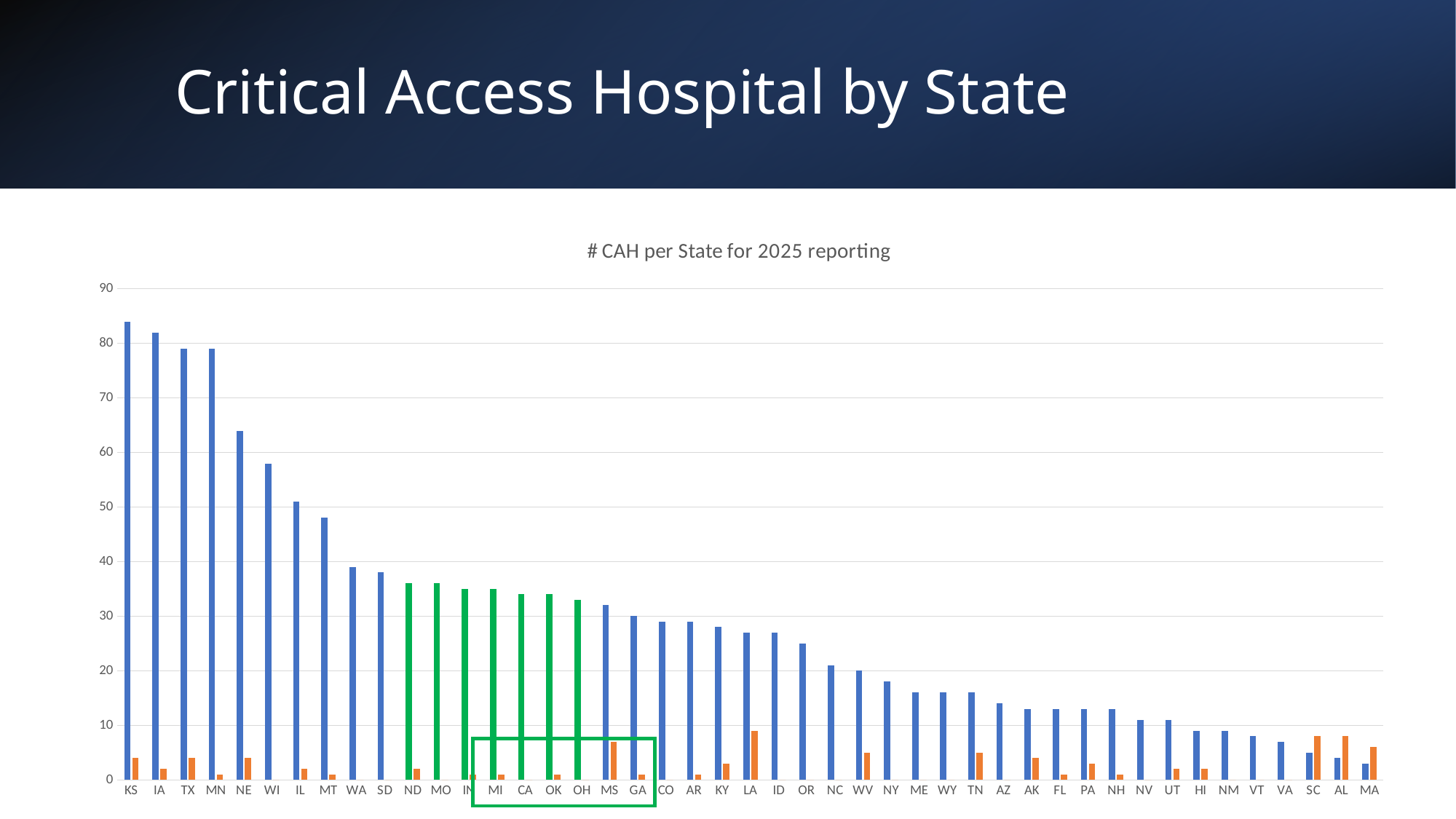
Do the blue bar values generally rise or fall moving from left to right along the x axis? fall Is the blue bar value for NE greater or less than 60? greater Is the blue bar value for OR greater or less than 30? less Is the blue bar value for MA greater or less than 10? less Which state has the larger blue bar, TX or NE? TX How many states are listed along the x axis of the chart? 45 What kind of chart is shown on the slide? bar chart Which state has the tallest blue bar in the chart? KS Which state has the larger blue bar, NC or WY? NC What is the title of the chart? # CAH per State for 2025 reporting